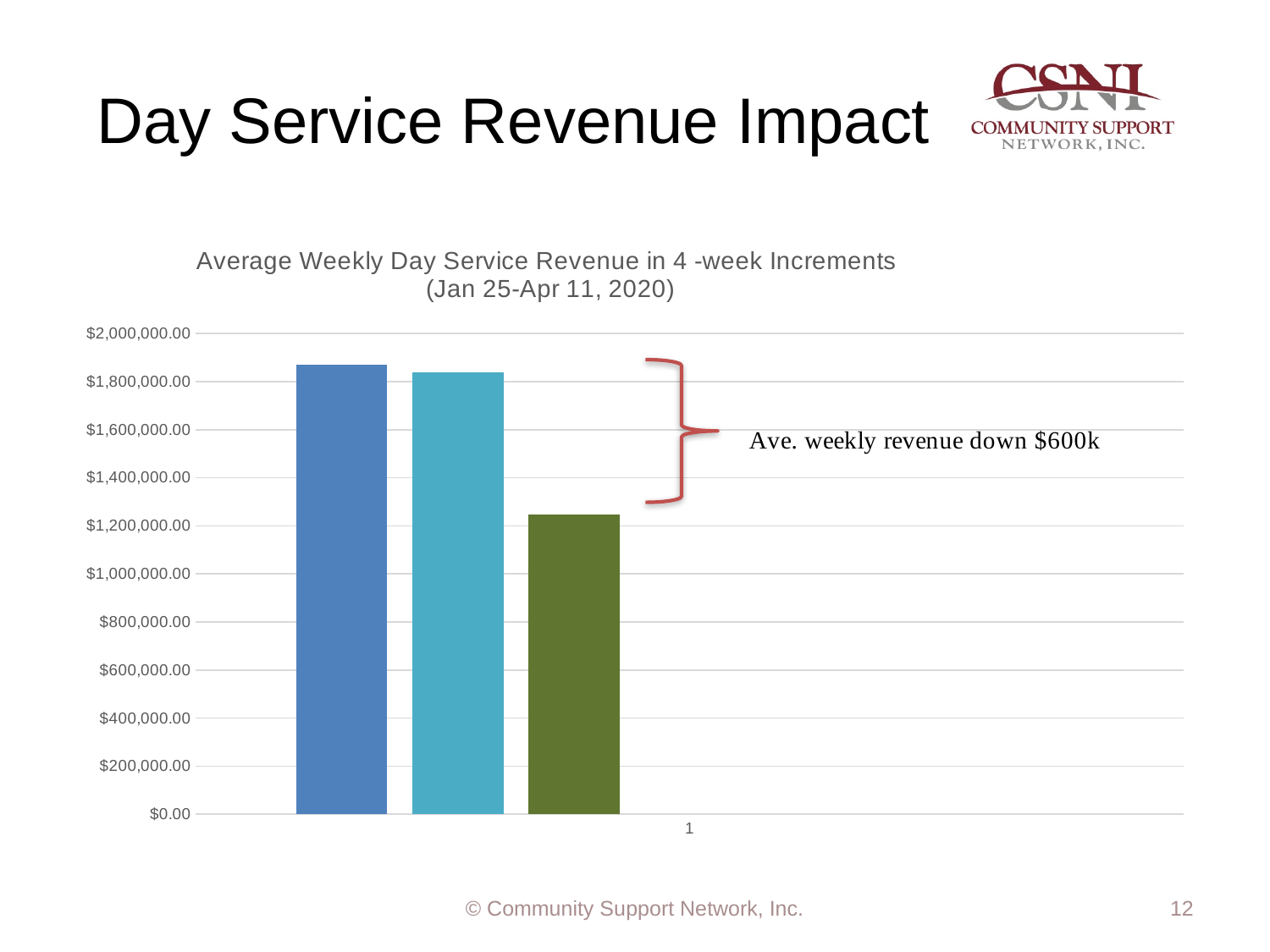
Which bar is the lowest in the chart? the green bar (rightmost) Is the value of the teal (middle) bar greater or less than $1,600,000.00? greater What is the title of the chart? Average Weekly Day Service Revenue in 4 -week Increments (Jan 25-Apr 11, 2020) Is the value of the green (rightmost) bar greater or less than $1,200,000.00? greater Is the value of the blue (leftmost) bar greater or less than $2,000,000.00? less How many bars are plotted in the chart? 3 What does the annotation next to the red bracket on the chart say? Ave. weekly revenue down $600k Which is larger, the blue (leftmost) bar or the green (rightmost) bar? the blue bar Which is larger, the teal (middle) bar or the green (rightmost) bar? the teal bar What kind of chart is shown on the slide? bar chart